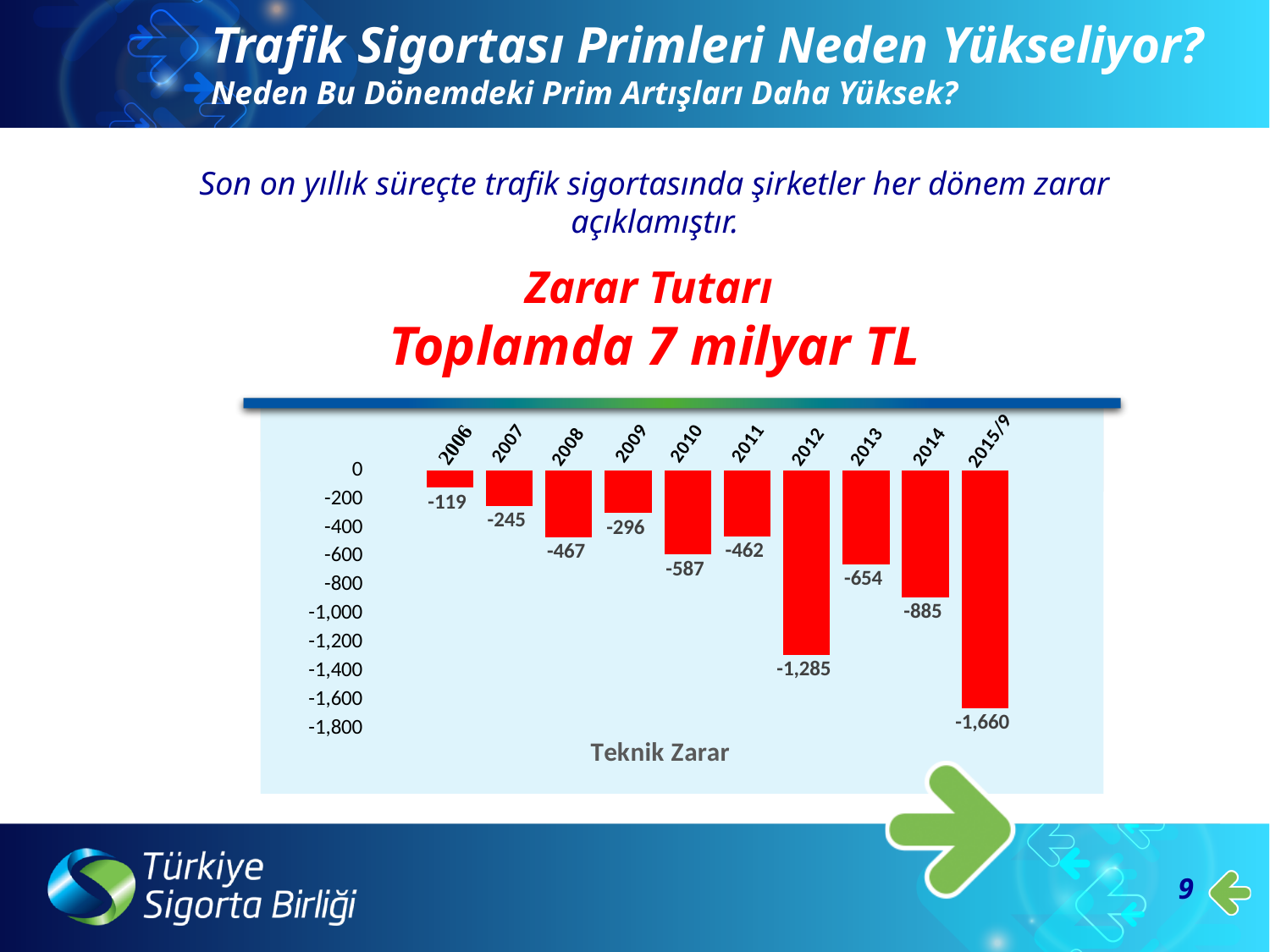
Which year has the lowest (most negative) value in the Teknik Zarar chart? 2015/9 What type of chart is used to show Teknik Zarar? Bar chart What is the value for 2010 in the Teknik Zarar chart? -587 What is the difference between the values for 2015/9 and 2014 in the Teknik Zarar chart? 775 What is the value for 2006 in the Teknik Zarar chart? -119 What is the value for 2015/9 in the Teknik Zarar chart? -1,660 What is the legend entry shown below the chart? Teknik Zarar Which year has the larger loss in the Teknik Zarar chart, 2008 or 2009? 2008 What is the value for 2012 in the Teknik Zarar chart? -1,285 Which year has the highest (least negative) value in the Teknik Zarar chart? 2006 What is the difference between the values for 2012 and 2013 in the Teknik Zarar chart? 631 How many years are shown on the x axis of the Teknik Zarar chart? 10